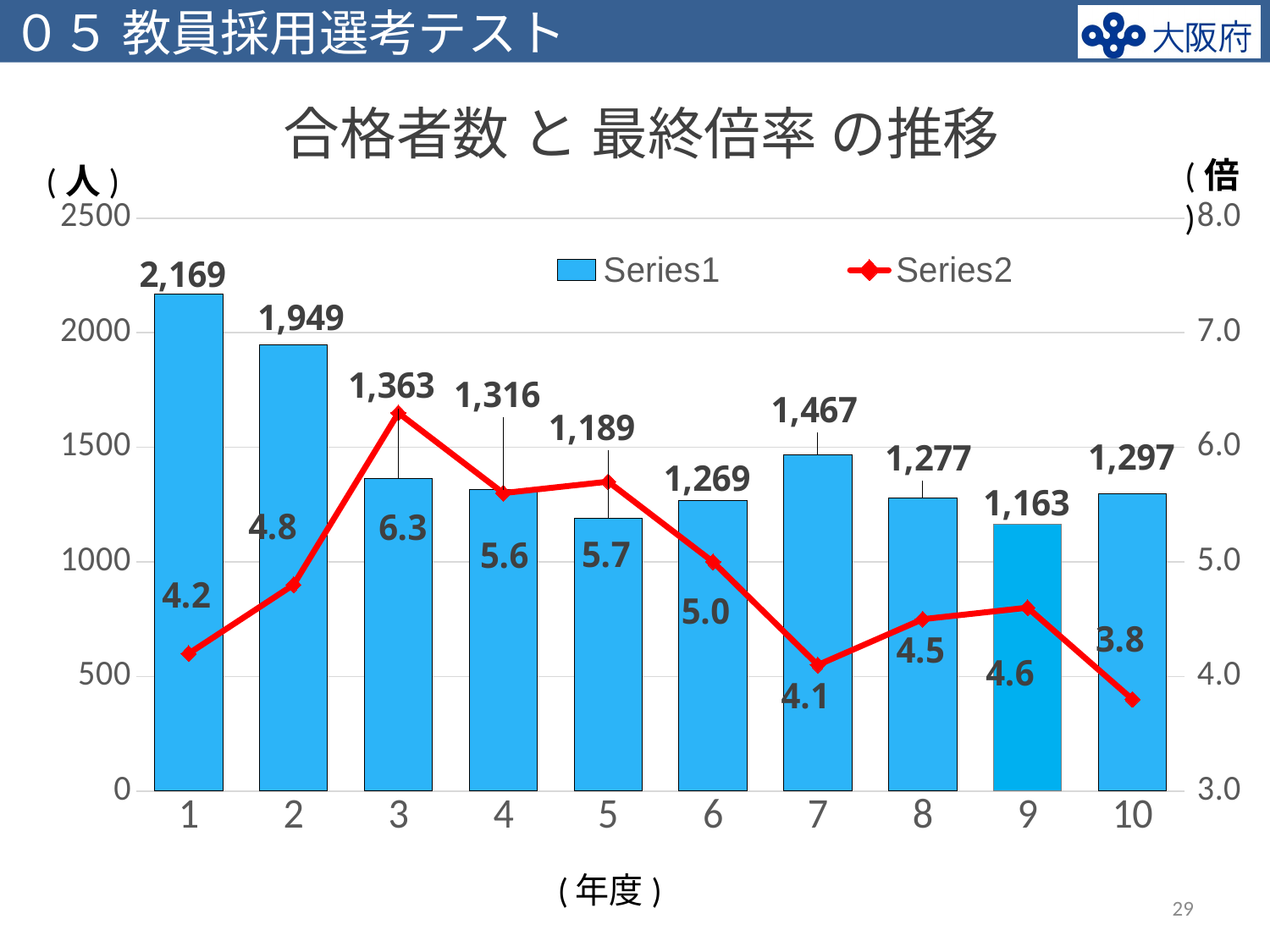
What is the Series1 value (number of successful candidates) for year 1? 2,169 What is the difference between the Series1 values for year 1 and year 2? 220 How many years (categories) are shown on the x axis? 10 What is the title of the chart? 合格者数 と 最終倍率 の推移 How many series does the legend list? 2 What is the Series1 value for year 9? 1,163 What is the Series2 value for year 10? 3.8 Which is larger, the Series1 value for year 7 or for year 8? Year 7 Which year has the highest Series1 value? 1 What is the Series2 value (final ratio) for year 3? 6.3 Which year has the highest Series2 value? 3 Which year has the lowest Series2 value? 10